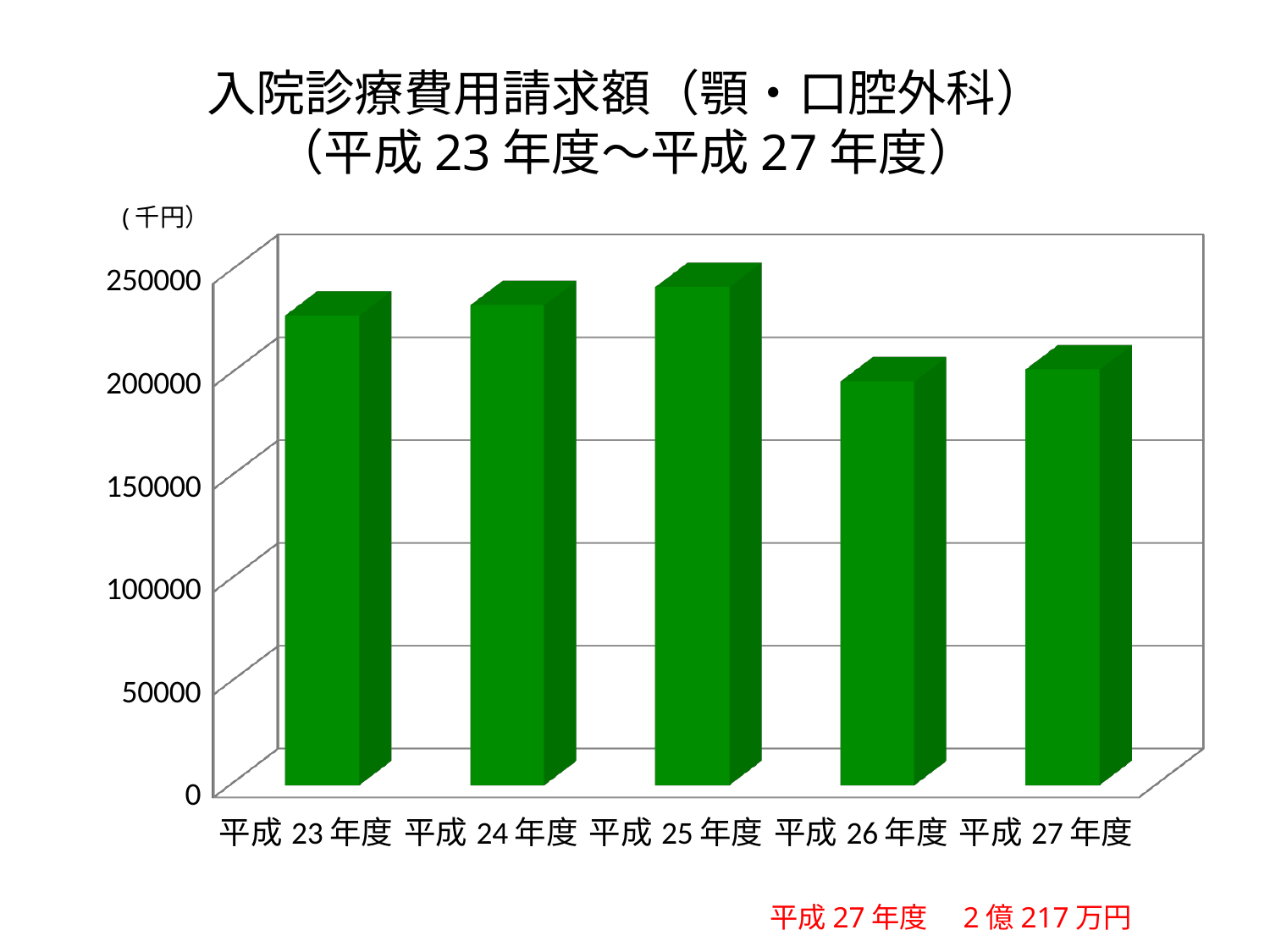
Is the value for 平成25年度 greater or less than 200000? greater What kind of chart is shown on the slide? bar chart What unit is shown above the vertical axis of the chart? 千円 What amount does the red note on the slide give for 平成27年度? 2億217万円 Is the value for 平成26年度 greater or less than 250000? less Is the value for 平成23年度 greater or less than 200000? greater Does the value rise or fall from 平成25年度 to 平成26年度? fall Which is larger, the value for 平成25年度 or the value for 平成26年度? 平成25年度 Which is larger, the value for 平成23年度 or the value for 平成26年度? 平成23年度 How many fiscal years (categories) are plotted on the chart? 5 Which fiscal year has the highest bar on the chart? 平成25年度